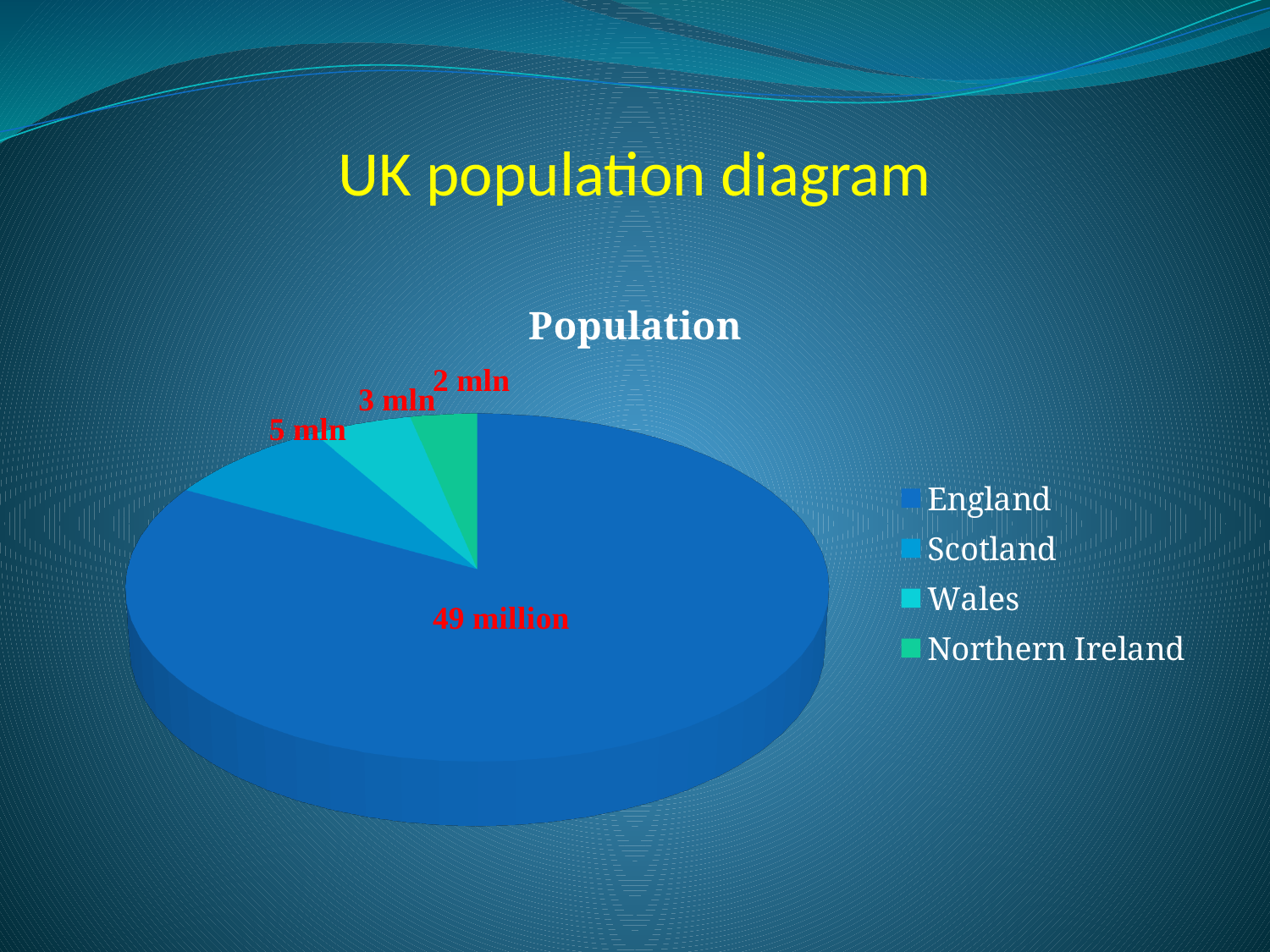
What is the population value shown for Wales? 3 mln Which country has the largest slice of the pie? England What is the title of the chart? Population Which has the larger population, Scotland or Wales? Scotland How many countries are shown in the pie chart? 4 Which country has the smallest slice of the pie? Northern Ireland What is the difference in millions between the Scotland and Northern Ireland values? 3 mln What is the population value shown for Northern Ireland? 2 mln What is the population value shown for England? 49 million What is the population value shown for Scotland? 5 mln What type of chart is shown on the slide? Pie chart Which country is listed last in the legend? Northern Ireland